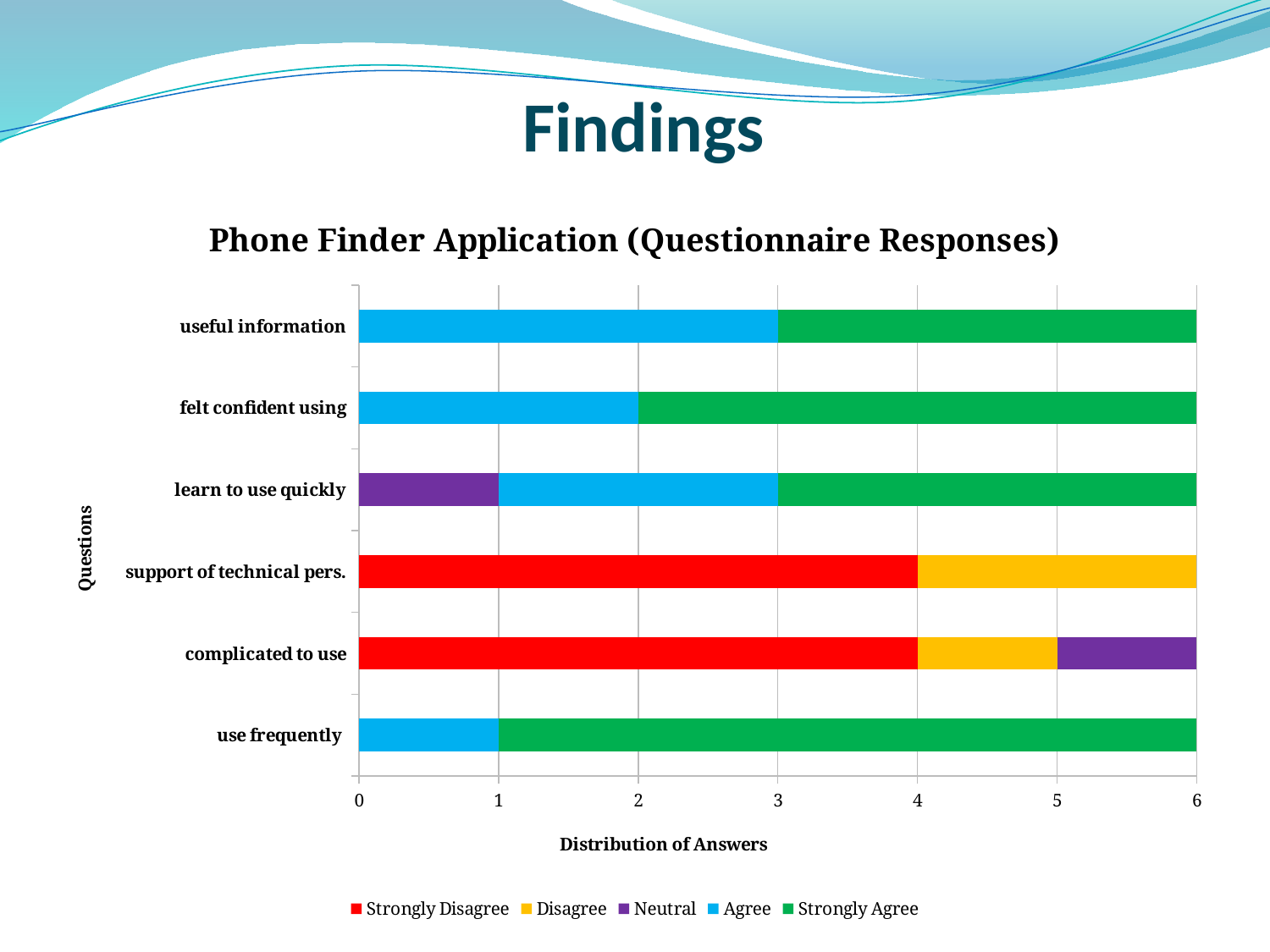
How many series does the legend list? 5 What is the Neutral value for "learn to use quickly"? 1 What is the total length of the stacked bar for "complicated to use"? 6 Which question has the largest Strongly Agree value? use frequently Which has the larger Strongly Agree value, "use frequently" or "useful information"? use frequently What is the Agree value for "use frequently"? 1 What kind of chart is shown on the slide? bar chart What is the title of the horizontal axis? Distribution of Answers What is the difference between the Strongly Agree values for "use frequently" and "useful information"? 2 What is the Strongly Agree value for "felt confident using"? 4 How many questions (categories) are plotted on the chart? 6 What is the Strongly Disagree value for "support of technical pers."? 4